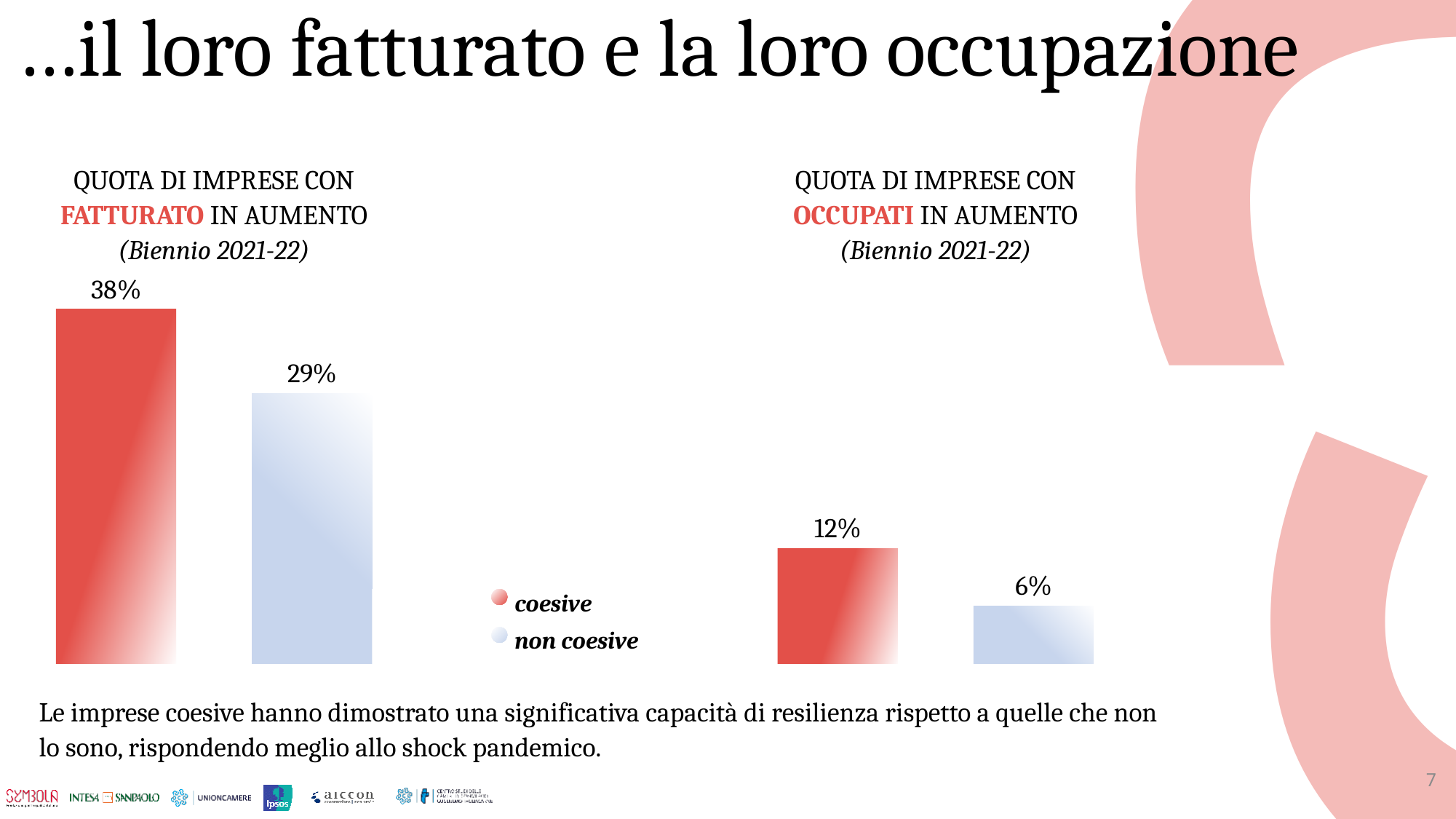
In the chart 'Quota di imprese con fatturato in aumento', which group has the lowest value? non coesive In the chart 'Quota di imprese con occupati in aumento', which group has the higher value, coesive or non coesive? coesive In the chart 'Quota di imprese con occupati in aumento', what is the value for non coesive? 6% In the chart 'Quota di imprese con occupati in aumento', what is the value for coesive? 12% In the chart 'Quota di imprese con fatturato in aumento', what is the difference between coesive and non coesive? 9 percentage points Which colour represents 'coesive' in the legend? red How many bars are shown in the chart 'Quota di imprese con occupati in aumento'? 2 In the chart 'Quota di imprese con fatturato in aumento', what is the value for non coesive? 29% What kind of chart is used on the left side of the slide? bar chart In the chart 'Quota di imprese con occupati in aumento', what is the difference between coesive and non coesive? 6 percentage points How many series does the legend list? 2 In the chart 'Quota di imprese con fatturato in aumento', what is the value for coesive? 38%